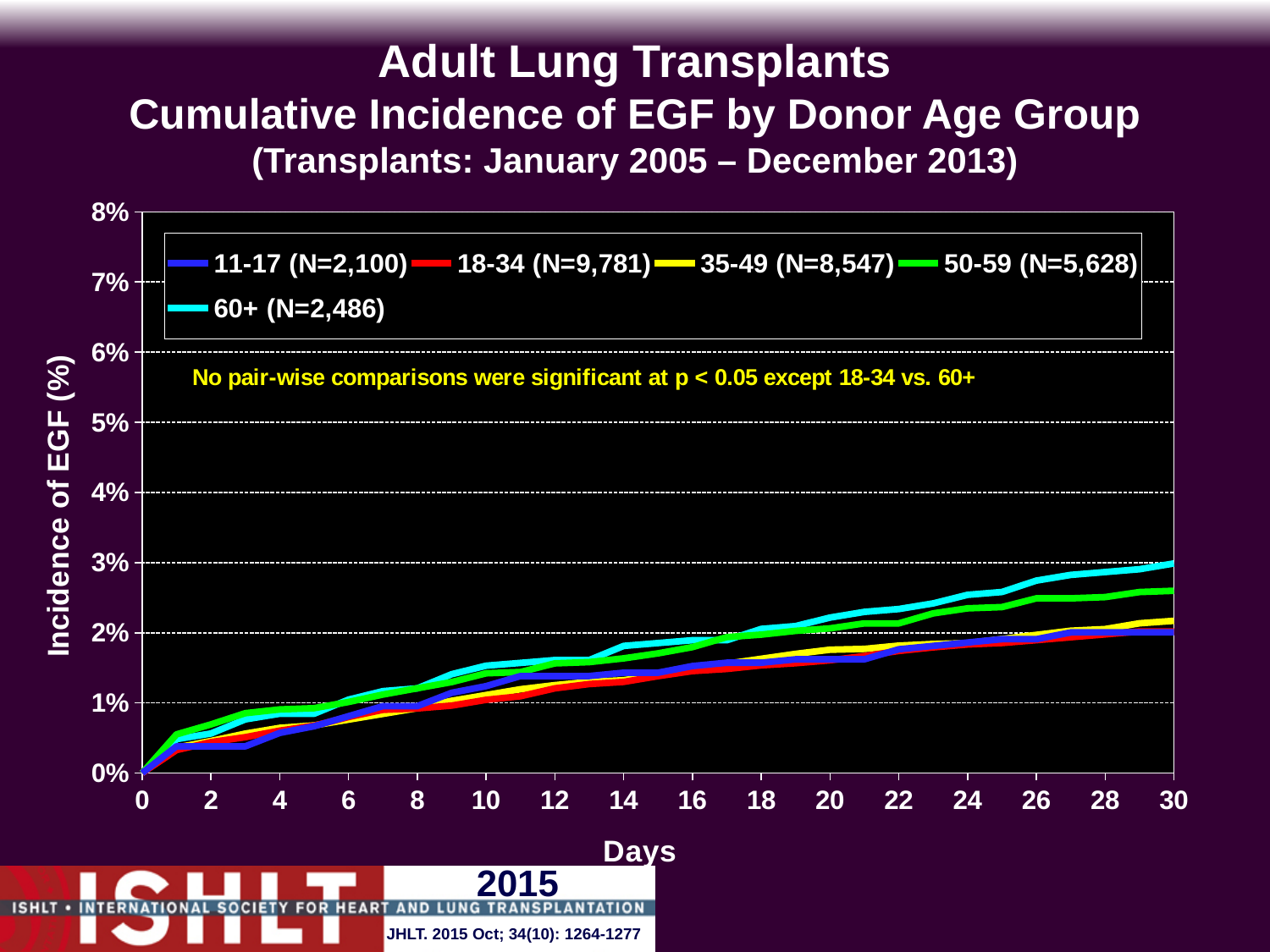
Is the incidence of EGF for the 18-34 group at day 30 greater or less than 3%? less Is the incidence of EGF for the 50-59 group at day 30 greater or less than 2%? greater Is the incidence of EGF for the 60+ group at day 30 greater or less than 2%? greater Which donor age group has the highest cumulative incidence of EGF at day 30? 60+ Do the cumulative incidence curves rise or fall as days increase? rise At day 30, which group has the higher incidence of EGF: 50-59 or 35-49? 50-59 What is the number of transplants (N) for the 18-34 donor age group shown in the legend? 9,781 At day 30, which group has the higher incidence of EGF: 60+ or 18-34? 60+ How many donor age groups does the legend list? 5 What is the label of the y axis? Incidence of EGF (%) What kind of chart is shown on the slide? line chart